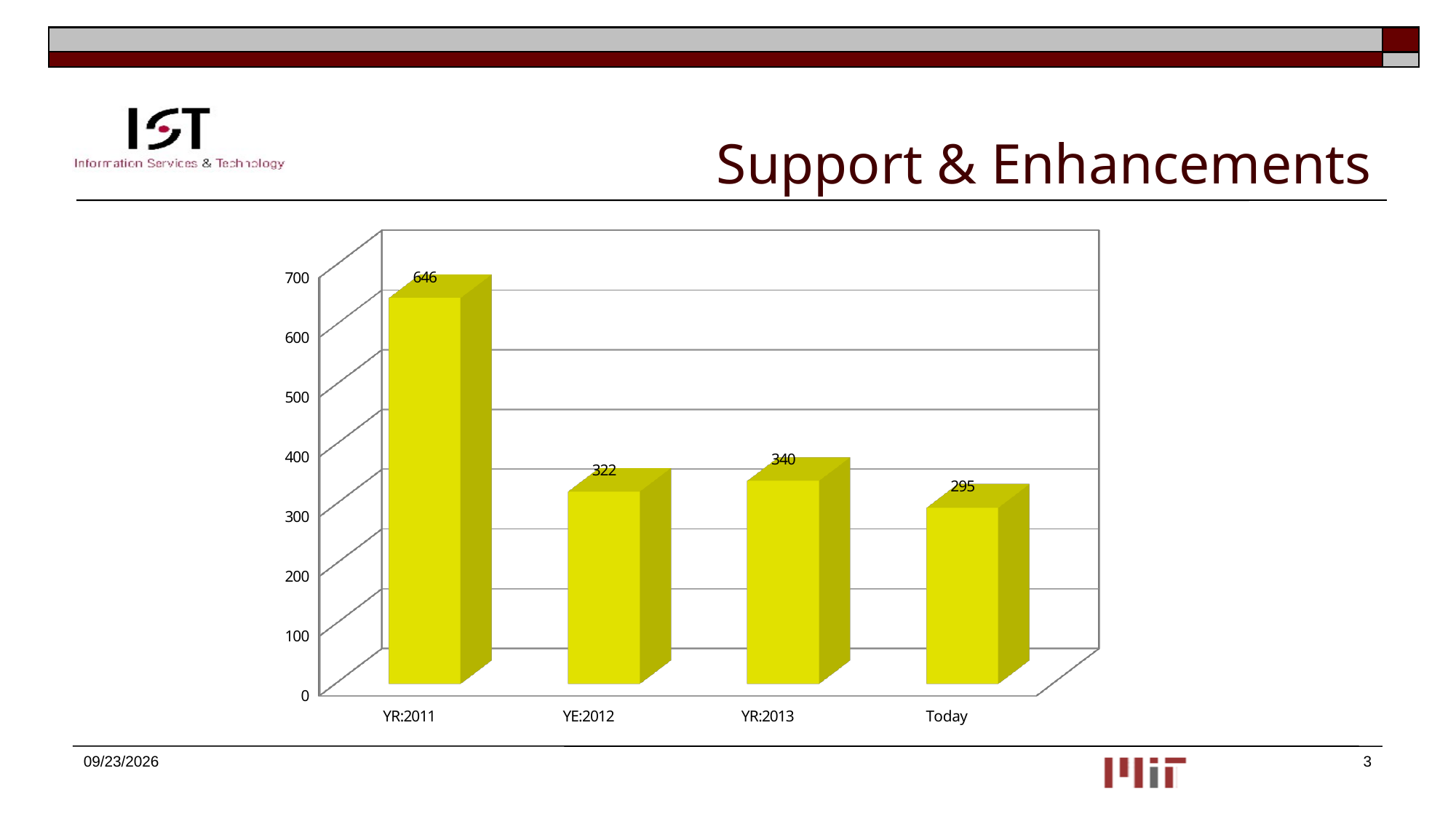
What is the value for YR:2011? 646 What kind of chart is shown on the slide? bar chart How many categories are shown on the x axis? 4 What is the title of the slide containing the chart? Support & Enhancements What is the value for YR:2013? 340 Which category has the lowest value? Today What is the difference between the values for YR:2011 and YE:2012? 324 What is the value for Today? 295 Which is larger, the value for YE:2012 or the value for YR:2013? YR:2013 Which category has the highest value? YR:2011 What is the difference between the values for YR:2013 and Today? 45 What is the value for YE:2012? 322